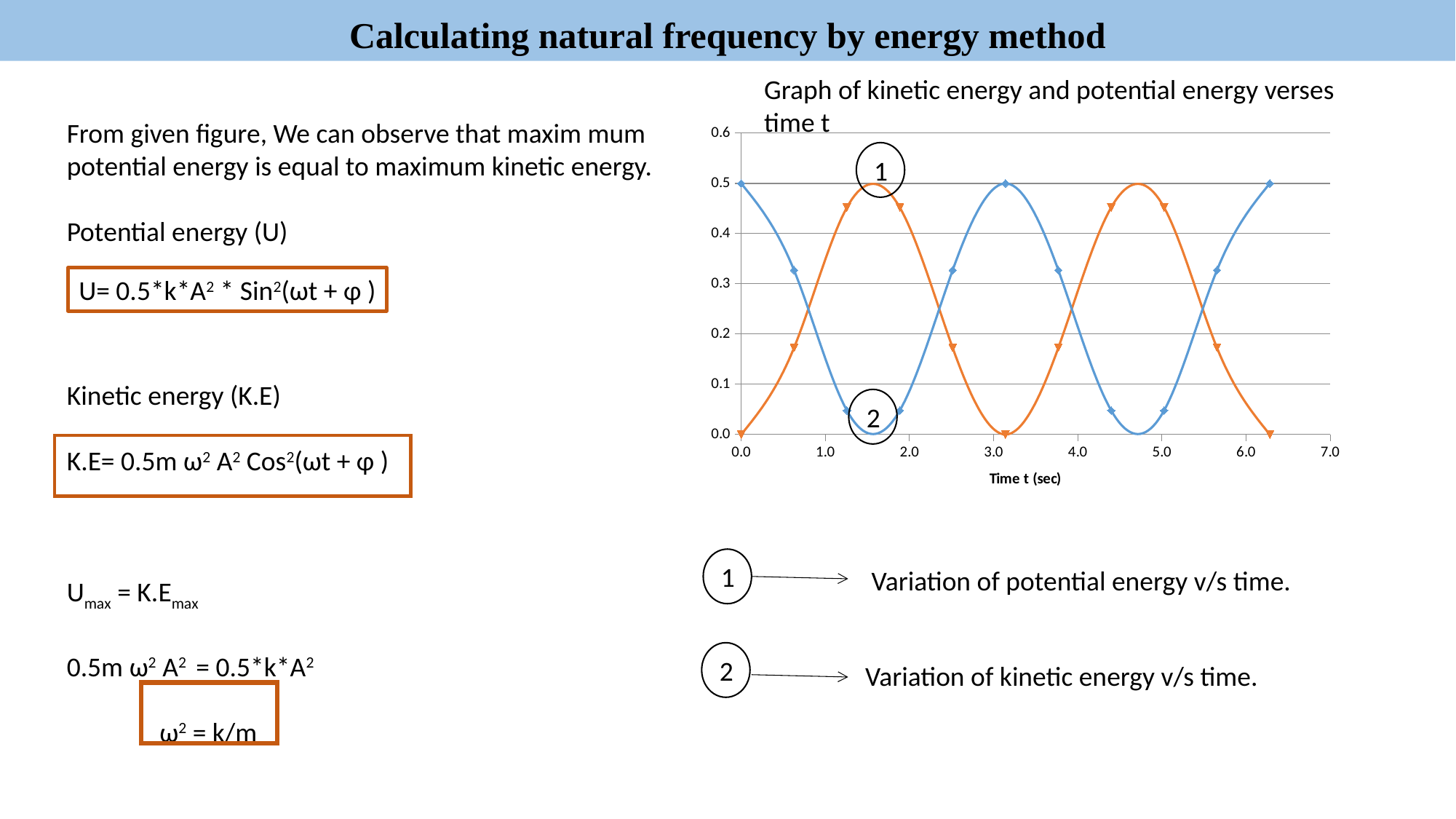
Is the value of the blue kinetic energy curve at time 0.5 sec greater or less than 0.3? greater How many curves are plotted on the chart? 2 What is the value of the potential energy curve (orange, labeled 1) at time 0.0 sec? 0.0 At time 3.0 sec, which curve has the higher value, the blue kinetic energy curve or the orange potential energy curve? blue kinetic energy curve What is the value of the kinetic energy curve (blue, labeled 2) at time 0.0 sec? 0.5 What is the x-axis title of the chart? Time t (sec) Does the blue kinetic energy curve rise or fall between time 0.0 sec and 1.5 sec? fall At time 1.0 sec, which curve has the higher value, the blue kinetic energy curve or the orange potential energy curve? orange potential energy curve What kind of chart is shown on the slide? line chart What is the title of the chart on the slide? Graph of kinetic energy and potential energy verses time t